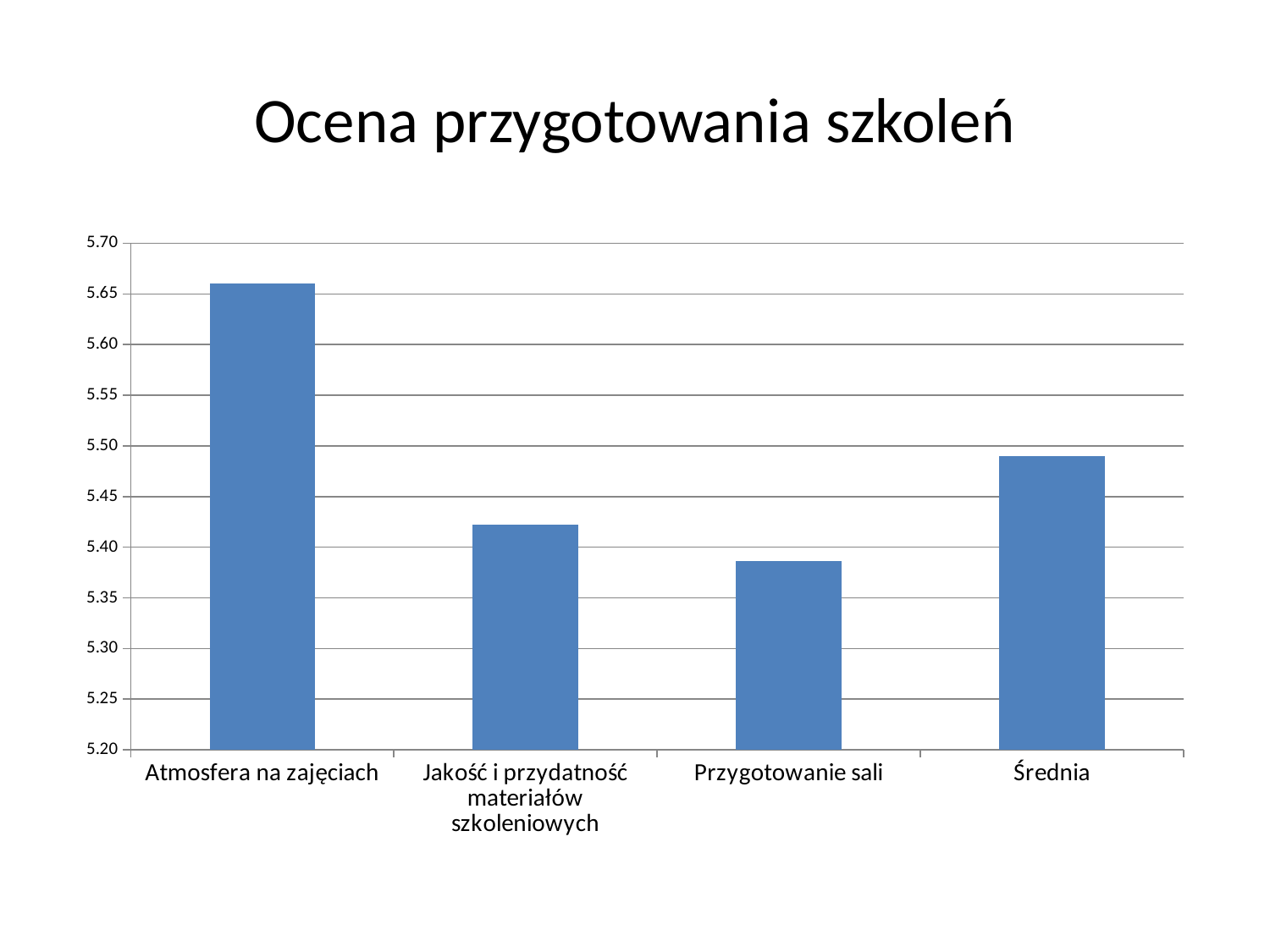
Is the value for Jakość i przydatność materiałów szkoleniowych greater or less than 5.45? less Is the value for Atmosfera na zajęciach greater or less than 5.60? greater Which is larger, the value for Atmosfera na zajęciach or the value for Jakość i przydatność materiałów szkoleniowych? Atmosfera na zajęciach Which is larger, the value for Średnia or the value for Przygotowanie sali? Średnia How many categories are shown on the x axis of the chart? 4 Is the value for Średnia greater or less than 5.50? less What is the lowest value shown on the y axis of the chart? 5.20 What kind of chart is shown on the slide? bar chart Which category has the highest value? Atmosfera na zajęciach What is the title of the chart? Ocena przygotowania szkoleń Which category has the lowest value? Przygotowanie sali